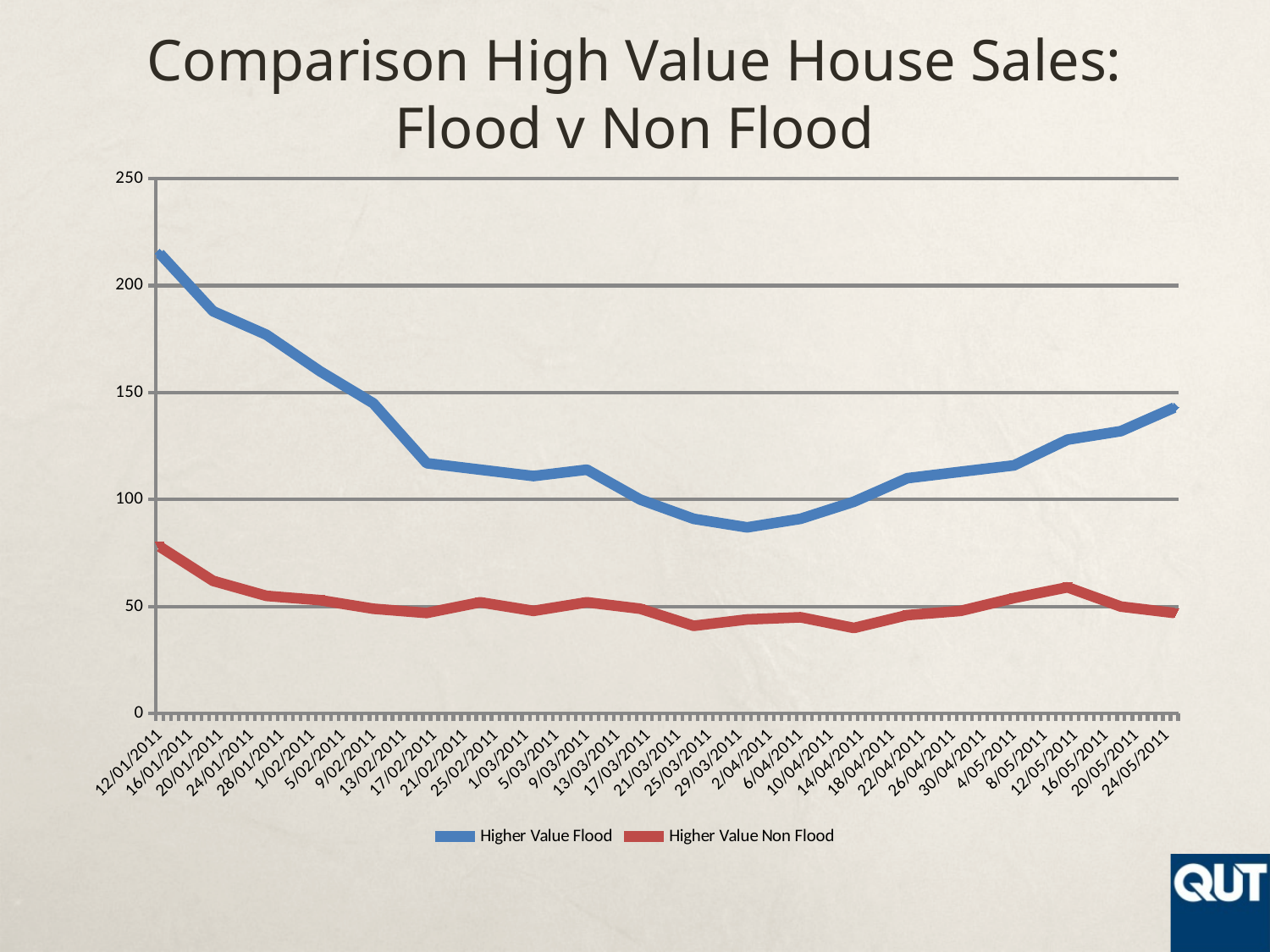
What are the two series named in the legend? Higher Value Flood and Higher Value Non Flood On which date is the Higher Value Non Flood series at its highest? 12/01/2011 Does the Higher Value Flood series rise or fall between 12/01/2011 and 9/02/2011? Fall On which date is the Higher Value Flood series at its highest? 12/01/2011 How many series does the legend list? 2 Is the value for Higher Value Flood on 29/03/2011 greater or less than 100? less What kind of chart is shown on the slide? Line chart Which series is higher on 24/05/2011, Higher Value Flood or Higher Value Non Flood? Higher Value Flood Is the value for Higher Value Non Flood on 12/01/2011 greater or less than 50? greater Is the value for Higher Value Flood on 12/01/2011 greater or less than 200? greater